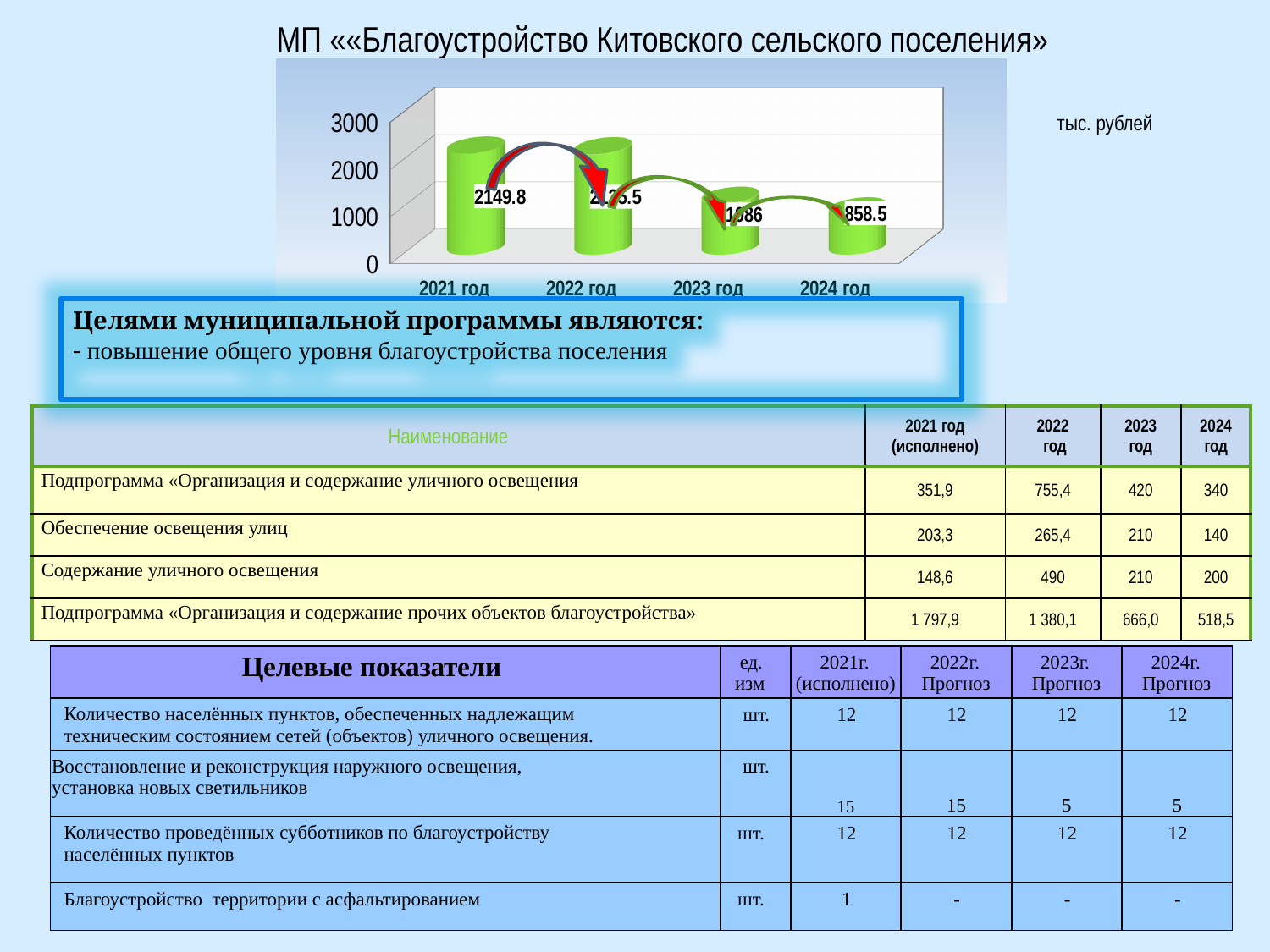
Which year has the lowest value in the chart? 2024 год Is the value for 2023 год in the chart greater or less than 2000? less What is the value shown for 2021 год in the chart? 2149.8 What is the value shown for 2024 год in the chart? 858.5 Do the values in the chart rise or fall from 2021 год to 2024 год? fall In what units are the chart values expressed, according to the label next to the chart? тыс. рублей What kind of chart is shown on the slide? bar chart Is the value for 2022 год in the chart greater or less than 2000? greater How many years are shown on the x axis of the chart? 4 What is the difference between the values for 2021 год and 2024 год in the chart? 1291.3 Which is larger in the chart, the value for 2021 год or the value for 2024 год? 2021 год Which year has the highest value in the chart? 2021 год